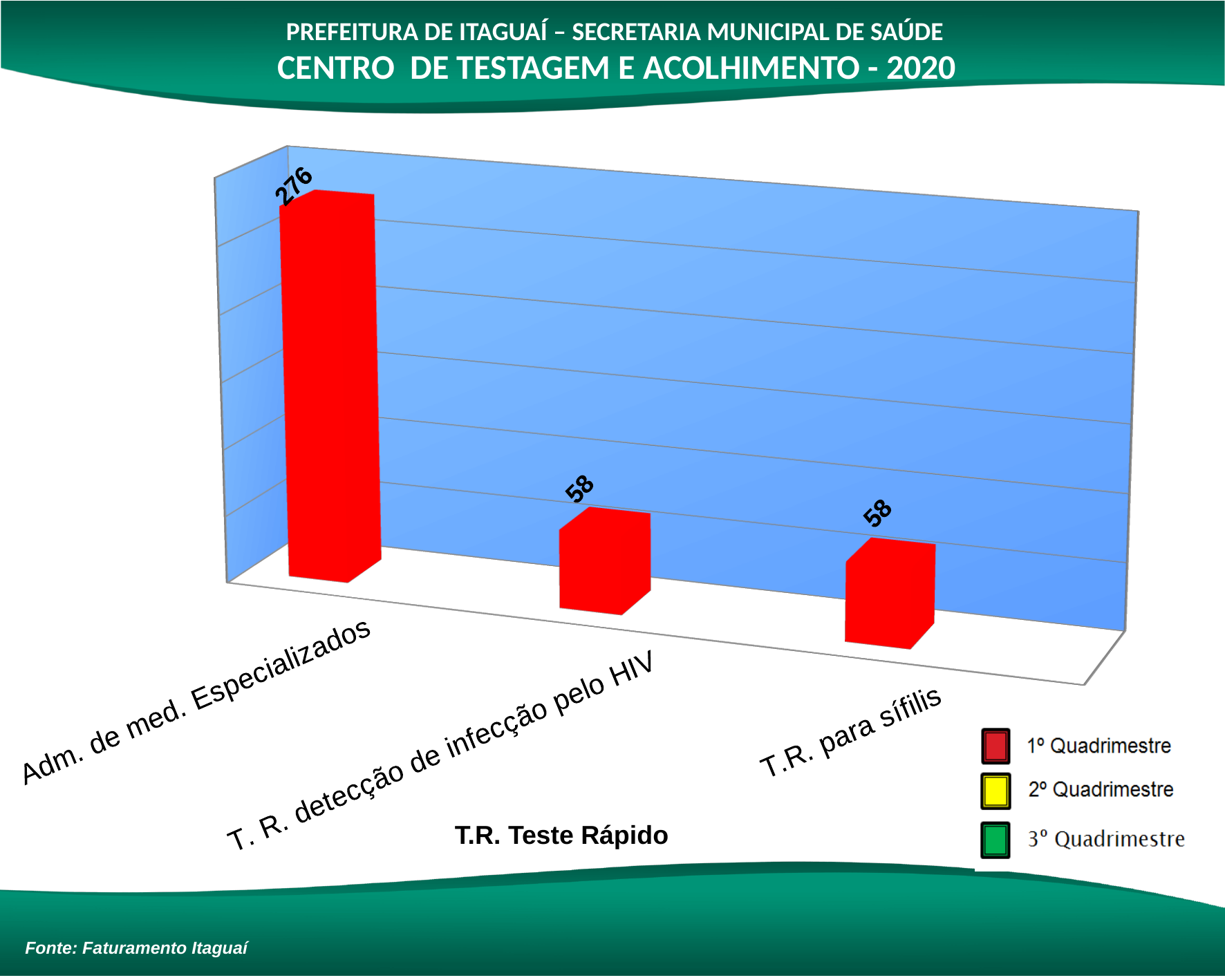
What is the difference between the values for Adm. de med. Especializados and T.R. para sífilis? 218 Which legend entry is shown in red? 1º Quadrimestre What kind of chart is shown on the slide? Bar chart What is the total of the three plotted values? 392 Which is larger, the value for Adm. de med. Especializados or the value for T. R. detecção de infecção pelo HIV? Adm. de med. Especializados What is the value for T. R. detecção de infecção pelo HIV? 58 What is the value for T.R. para sífilis? 58 How many categories are shown on the x axis? 3 What is the value for Adm. de med. Especializados? 276 What does the abbreviation T.R. stand for according to the slide? Teste Rápido How many series does the legend list? 3 Which category has the highest value? Adm. de med. Especializados